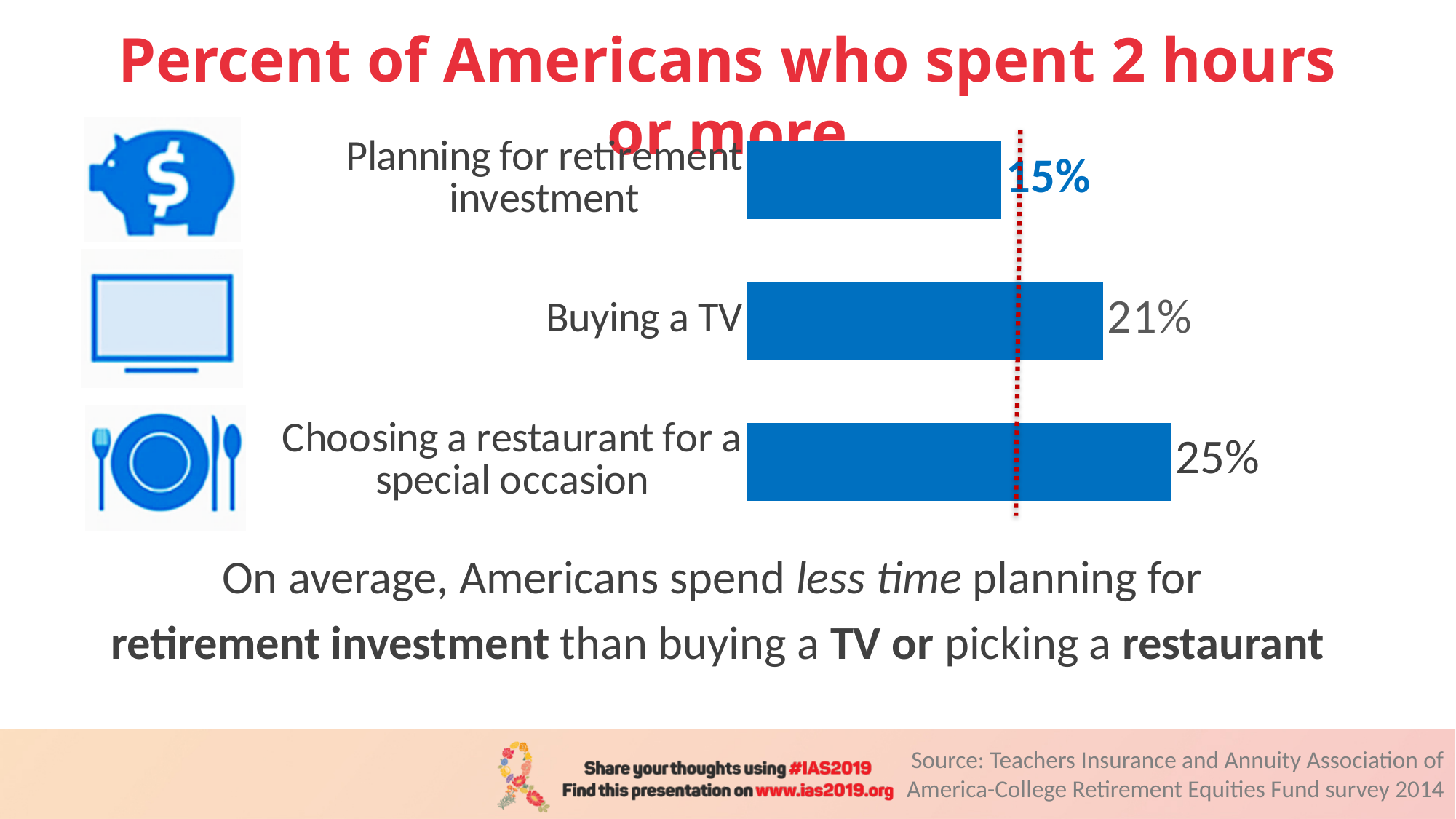
Which bar's data label is shown in blue rather than grey? Planning for retirement investment How many activities are shown in the chart? 3 What is the title of the chart on the slide? Percent of Americans who spent 2 hours or more What percent of Americans spent 2 hours or more planning for retirement investment? 15% What percent of Americans spent 2 hours or more buying a TV? 21% What is the difference in percentage points between buying a TV and planning for retirement investment? 6 What percent of Americans spent 2 hours or more choosing a restaurant for a special occasion? 25% Which activity has the lowest percentage of Americans spending 2 hours or more? Planning for retirement investment Which activity has the highest percentage of Americans spending 2 hours or more? Choosing a restaurant for a special occasion Which is larger: the percentage for buying a TV or for planning for retirement investment? Buying a TV What type of chart is shown on the slide? Bar chart What is the difference in percentage points between choosing a restaurant for a special occasion and planning for retirement investment? 10